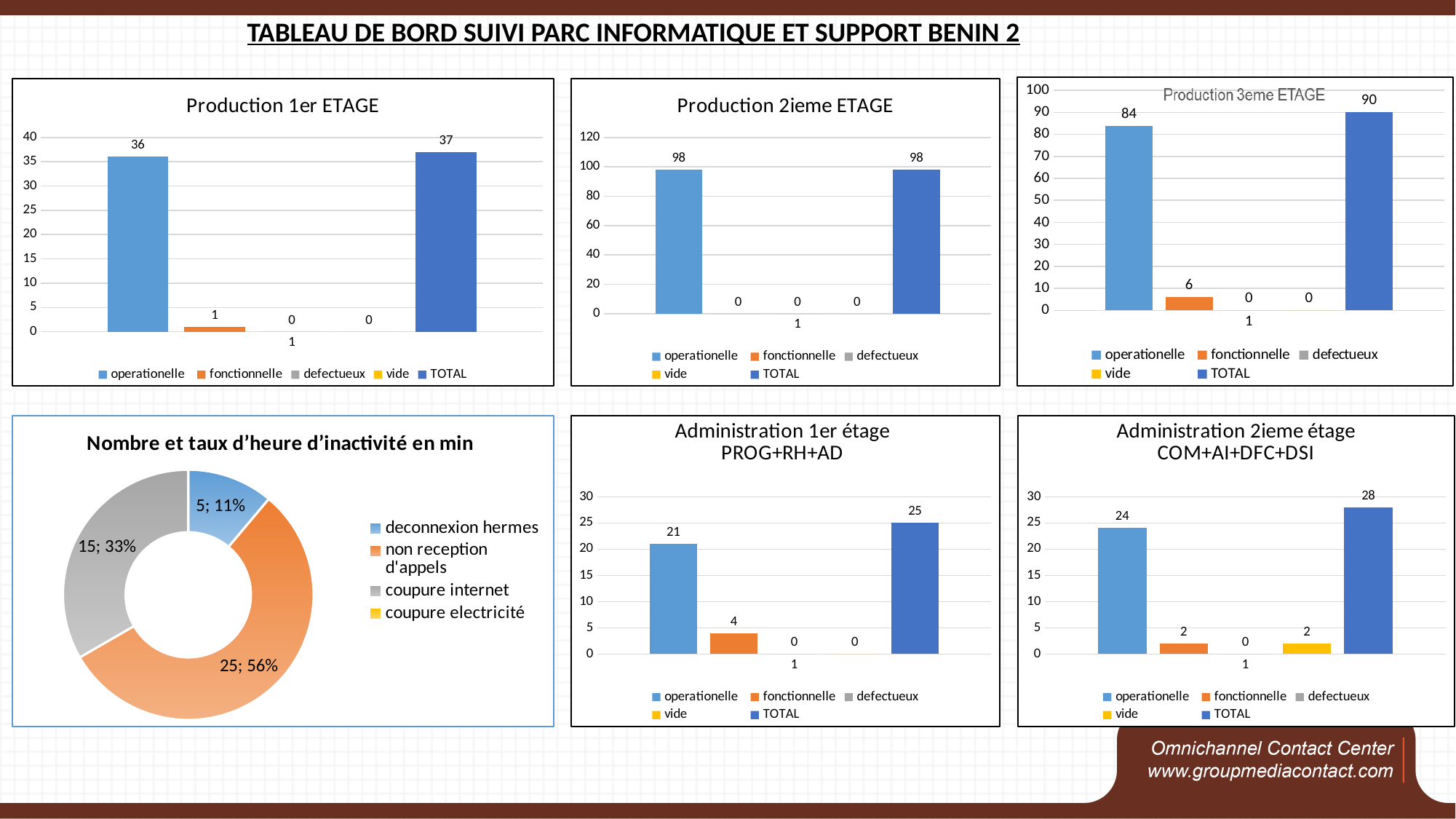
In the 'Production 1er ETAGE' chart, what is the value for operationelle? 36 In the 'Production 3eme ETAGE' chart, what is the value for fonctionnelle? 6 In the 'Nombre et taux d'heure d'inactivité en min' chart, what is the value for 'coupure internet'? 15 In the 'Administration 2ieme étage COM+AI+DFC+DSI' chart, what is the value for vide? 2 In the 'Production 3eme ETAGE' chart, what is the difference between TOTAL and operationelle? 6 In the 'Production 2ieme ETAGE' chart, what is the value for operationelle? 98 In the 'Administration 1er étage PROG+RH+AD' chart, which series has the highest value? TOTAL What kind of chart is 'Nombre et taux d'heure d'inactivité en min'? Doughnut chart In the 'Production 1er ETAGE' chart, what is the value for TOTAL? 37 In the 'Administration 2ieme étage COM+AI+DFC+DSI' chart, is the value for operationelle greater or less than 20? greater How many series does the legend of the 'Production 2ieme ETAGE' chart list? 5 In the 'Nombre et taux d'heure d'inactivité en min' chart, what share does 'non reception d'appels' have? 56%